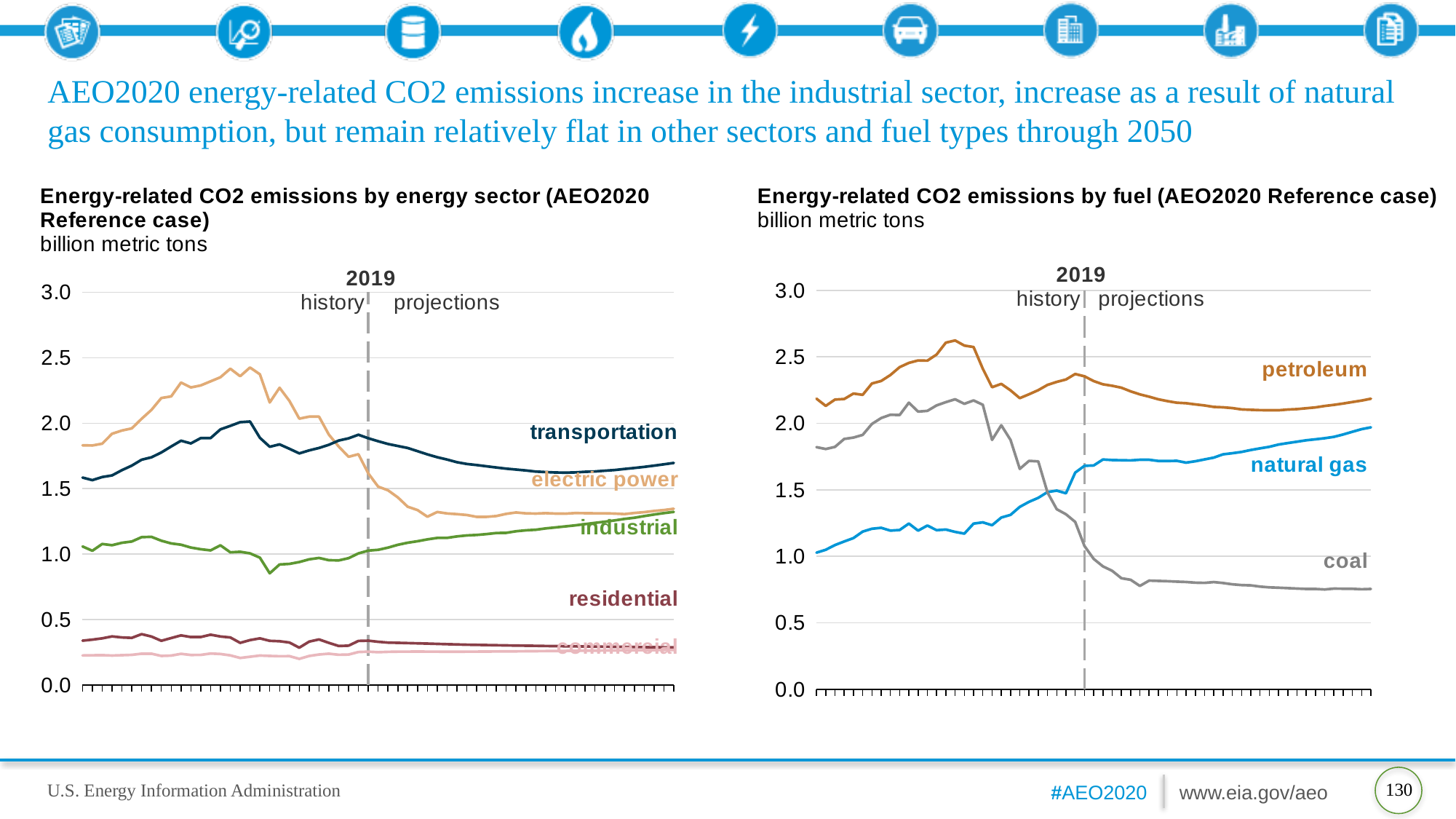
On the right chart, is the value for petroleum at the end of the projection period greater or less than 2.0? greater What kind of chart is the 'Energy-related CO2 emissions by fuel' chart on the right? line chart On the left chart, is the value for electric power at the end of the projection period greater or less than 1.5? less How many series are plotted on the left chart, 'Energy-related CO2 emissions by energy sector'? 5 On the left chart, which year does the dashed vertical line separating history from projections mark? 2019 How many series are plotted on the right chart, 'Energy-related CO2 emissions by fuel'? 3 On the right chart, which fuel has the lowest emissions at the end of the projection period? coal On the right chart, which fuel has the highest emissions at the end of the projection period? petroleum On the right chart, is the value for coal at the end of the projection period greater or less than 1.0? less On the left chart, do industrial emissions rise or fall over the projection period? rise On the left chart, which sector has the highest emissions at the end of the projection period? transportation On the right chart, do coal emissions rise or fall over the projection period? fall